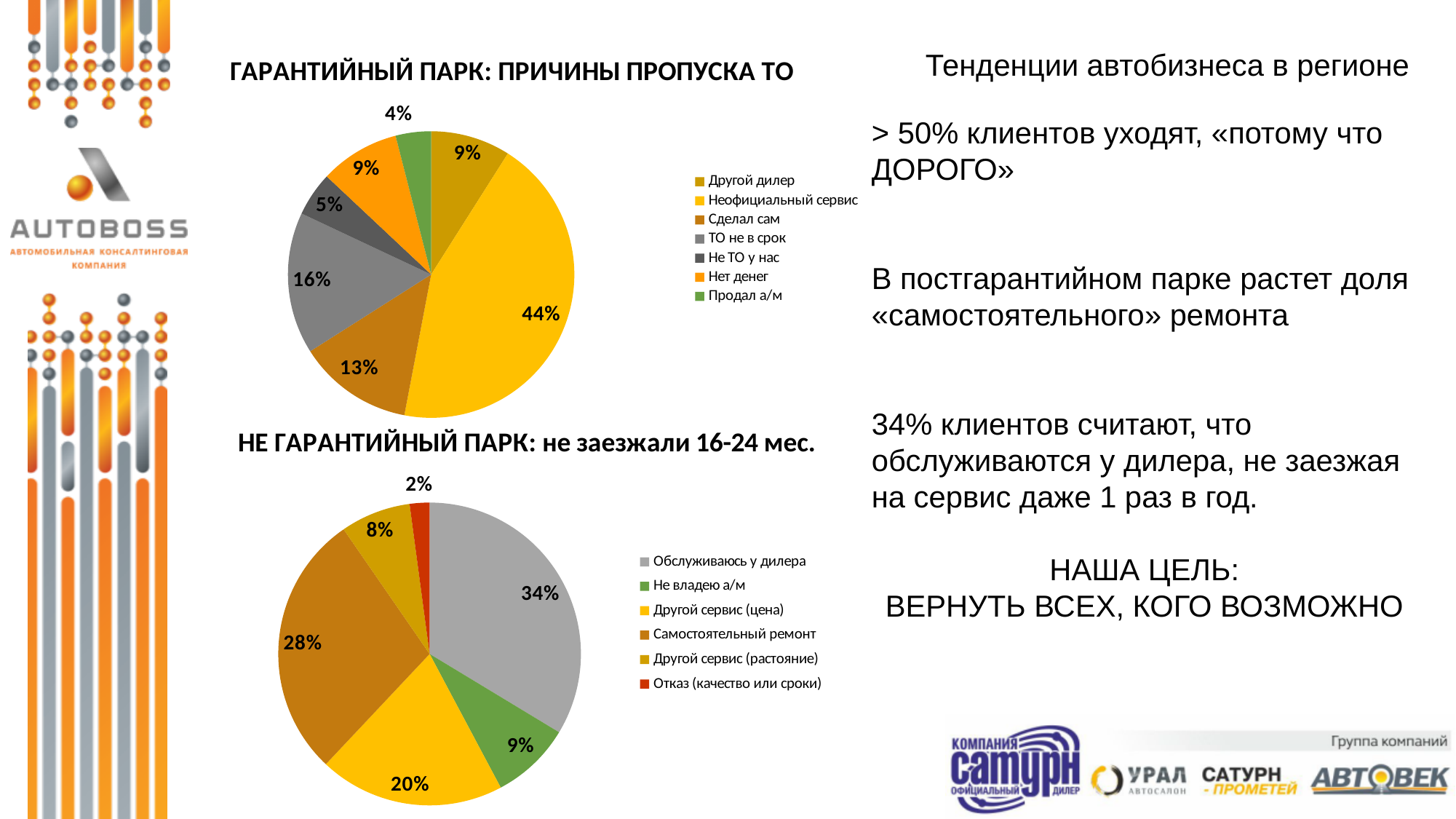
What type of chart is the bottom chart (НЕ ГАРАНТИЙНЫЙ ПАРК: не заезжали 16-24 мес.)? Pie chart In the top chart (ГАРАНТИЙНЫЙ ПАРК: ПРИЧИНЫ ПРОПУСКА ТО), what share is labelled for ТО не в срок? 16% In the bottom chart (НЕ ГАРАНТИЙНЫЙ ПАРК: не заезжали 16-24 мес.), what share is labelled for Самостоятельный ремонт? 28% In the top chart (ГАРАНТИЙНЫЙ ПАРК: ПРИЧИНЫ ПРОПУСКА ТО), what share is labelled for Неофициальный сервис? 44% In the bottom chart (НЕ ГАРАНТИЙНЫЙ ПАРК: не заезжали 16-24 мес.), which category has the largest slice? Обслуживаюсь у дилера In the top chart (ГАРАНТИЙНЫЙ ПАРК: ПРИЧИНЫ ПРОПУСКА ТО), how many categories does the legend list? 7 In the top chart (ГАРАНТИЙНЫЙ ПАРК: ПРИЧИНЫ ПРОПУСКА ТО), what colour is the slice for Продал а/м? Green In the top chart (ГАРАНТИЙНЫЙ ПАРК: ПРИЧИНЫ ПРОПУСКА ТО), which category has the smallest slice? Продал а/м In the bottom chart (НЕ ГАРАНТИЙНЫЙ ПАРК: не заезжали 16-24 мес.), which is larger: Другой сервис (цена) or Не владею а/м? Другой сервис (цена) In the bottom chart (НЕ ГАРАНТИЙНЫЙ ПАРК: не заезжали 16-24 мес.), how many categories does the legend list? 6 In the bottom chart (НЕ ГАРАНТИЙНЫЙ ПАРК: не заезжали 16-24 мес.), what share is labelled for Отказ (качество или сроки)? 2% In the top chart (ГАРАНТИЙНЫЙ ПАРК: ПРИЧИНЫ ПРОПУСКА ТО), what is the difference between the shares for Сделал сам and Не ТО у нас? 8%